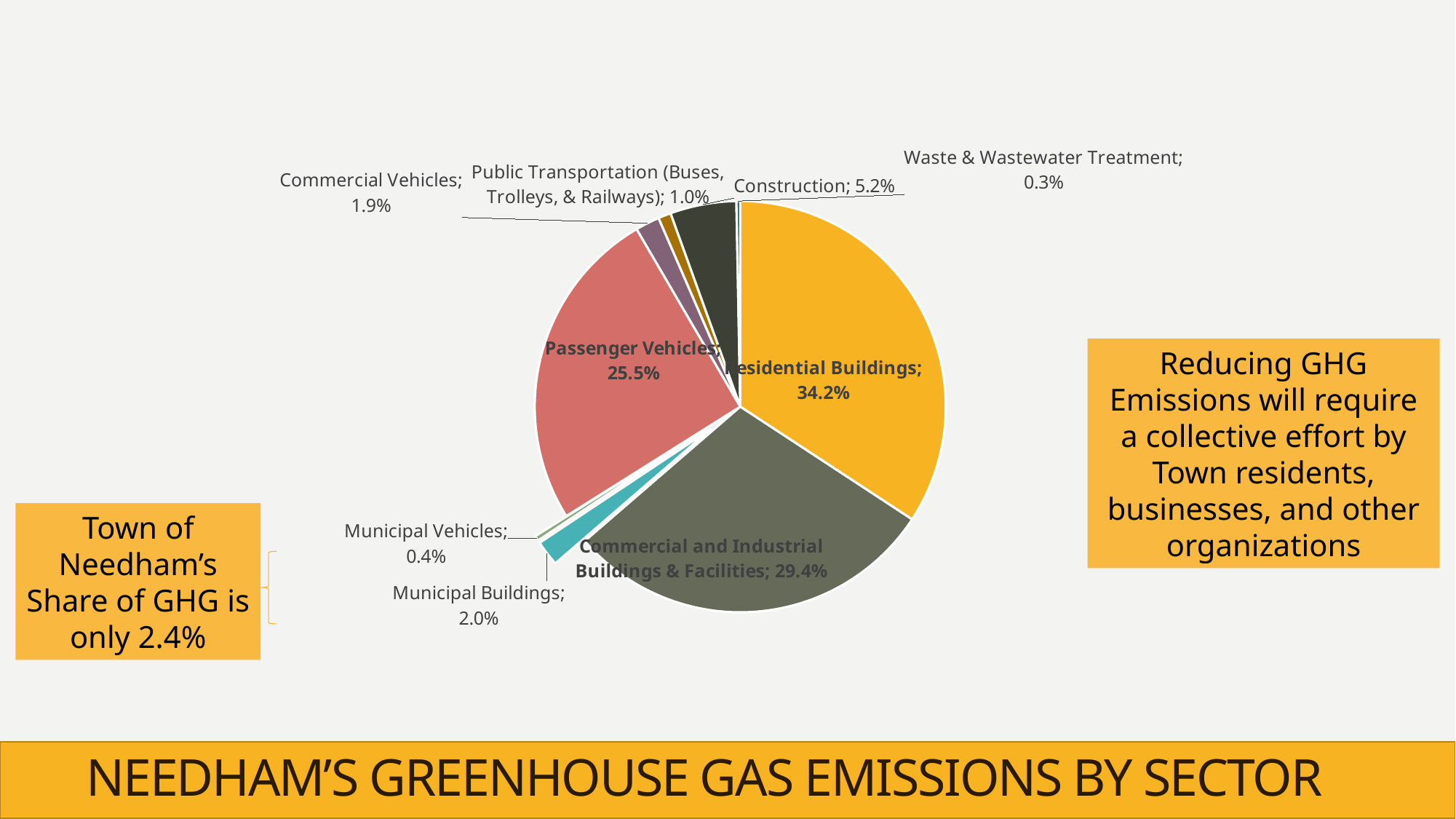
What share of Needham's greenhouse gas emissions comes from Residential Buildings? 34.2% What type of chart is shown on the slide? Pie chart Which sector has the smallest share of emissions? Waste & Wastewater Treatment What percentage of emissions comes from Construction? 5.2% How many sectors are shown in the pie chart? 9 Which sector has the largest share of emissions? Residential Buildings What percentage of emissions is attributed to Passenger Vehicles? 25.5% Which has a larger share, Municipal Buildings or Commercial Vehicles? Municipal Buildings What is the title of the slide? Needham's Greenhouse Gas Emissions by Sector What is the difference in percentage points between Residential Buildings and Passenger Vehicles? 8.7 What is the share for Commercial and Industrial Buildings & Facilities? 29.4% What is the share for Waste & Wastewater Treatment? 0.3%